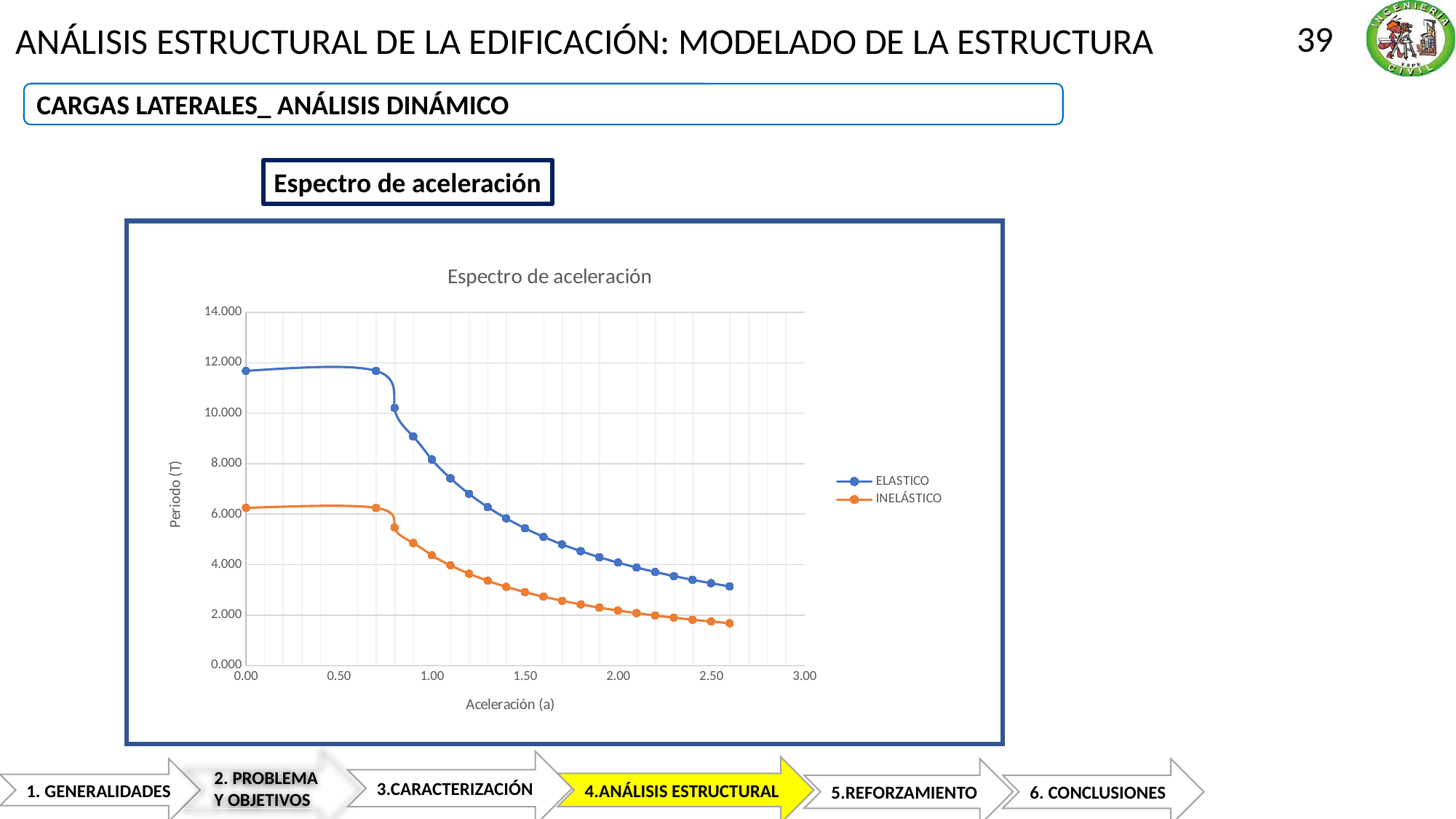
Is the value of the ELASTICO series at Aceleración (a) = 1.00 greater or less than 6.000? greater How many series does the legend list? 2 Is the value of the ELASTICO series at Aceleración (a) = 0.00 greater or less than 10.000? greater What kind of chart is shown on the slide? line chart What are the two series named in the legend? ELASTICO and INELÁSTICO Is the value of the INELÁSTICO series at Aceleración (a) = 0.00 greater or less than 8.000? less Which series has the larger value at Aceleración (a) = 1.00, ELASTICO or INELÁSTICO? ELASTICO Which series is plotted in orange? INELÁSTICO Do the values of the ELASTICO series rise or fall as Aceleración (a) increases beyond 0.70? fall What is the title of the chart? Espectro de aceleración